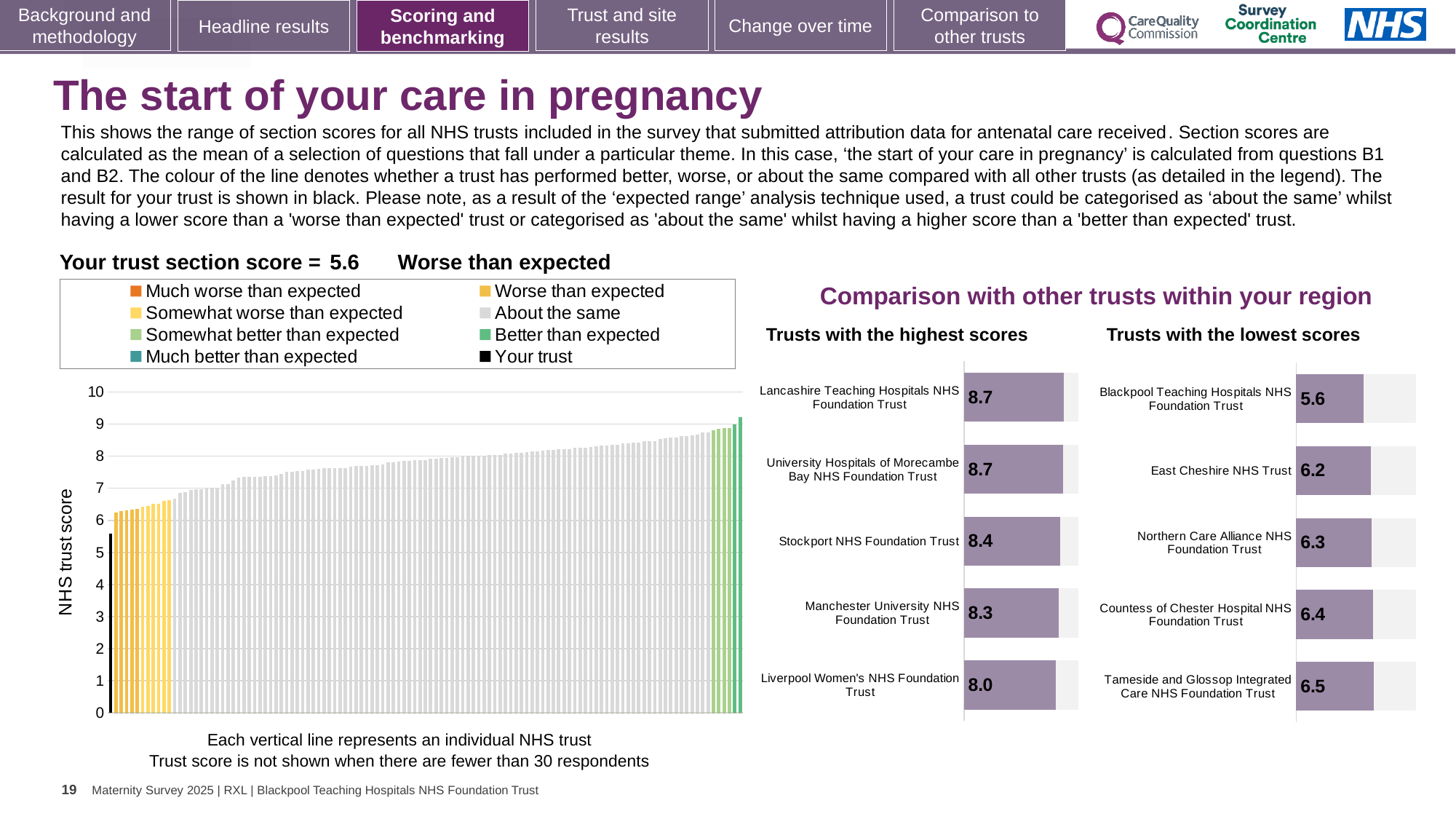
In the 'Trusts with the highest scores' chart, which trust has the lowest score? Liverpool Women's NHS Foundation Trust What kind of chart is the large chart on the left showing NHS trust scores? Bar chart In the large chart on the left, do the trust scores rise or fall from left to right? Rise Which has the higher score: Manchester University NHS Foundation Trust in the highest-scores chart or Countess of Chester Hospital NHS Foundation Trust in the lowest-scores chart? Manchester University NHS Foundation Trust In the 'Trusts with the lowest scores' chart, what is the score for East Cheshire NHS Trust? 6.2 In the 'Trusts with the highest scores' chart, what is the difference between the scores of Lancashire Teaching Hospitals NHS Foundation Trust and Liverpool Women's NHS Foundation Trust? 0.7 In the 'Trusts with the highest scores' chart, what is the score for Stockport NHS Foundation Trust? 8.4 How many trusts are listed in the 'Trusts with the highest scores' chart? 5 How many entries does the legend of the large chart on the left list? 8 In the 'Trusts with the lowest scores' chart, which trust has the lowest score? Blackpool Teaching Hospitals NHS Foundation Trust In the 'Trusts with the lowest scores' chart, what is the difference between the scores of Tameside and Glossop Integrated Care NHS Foundation Trust and Blackpool Teaching Hospitals NHS Foundation Trust? 0.9 In the 'Trusts with the lowest scores' chart, which trust has the highest score? Tameside and Glossop Integrated Care NHS Foundation Trust